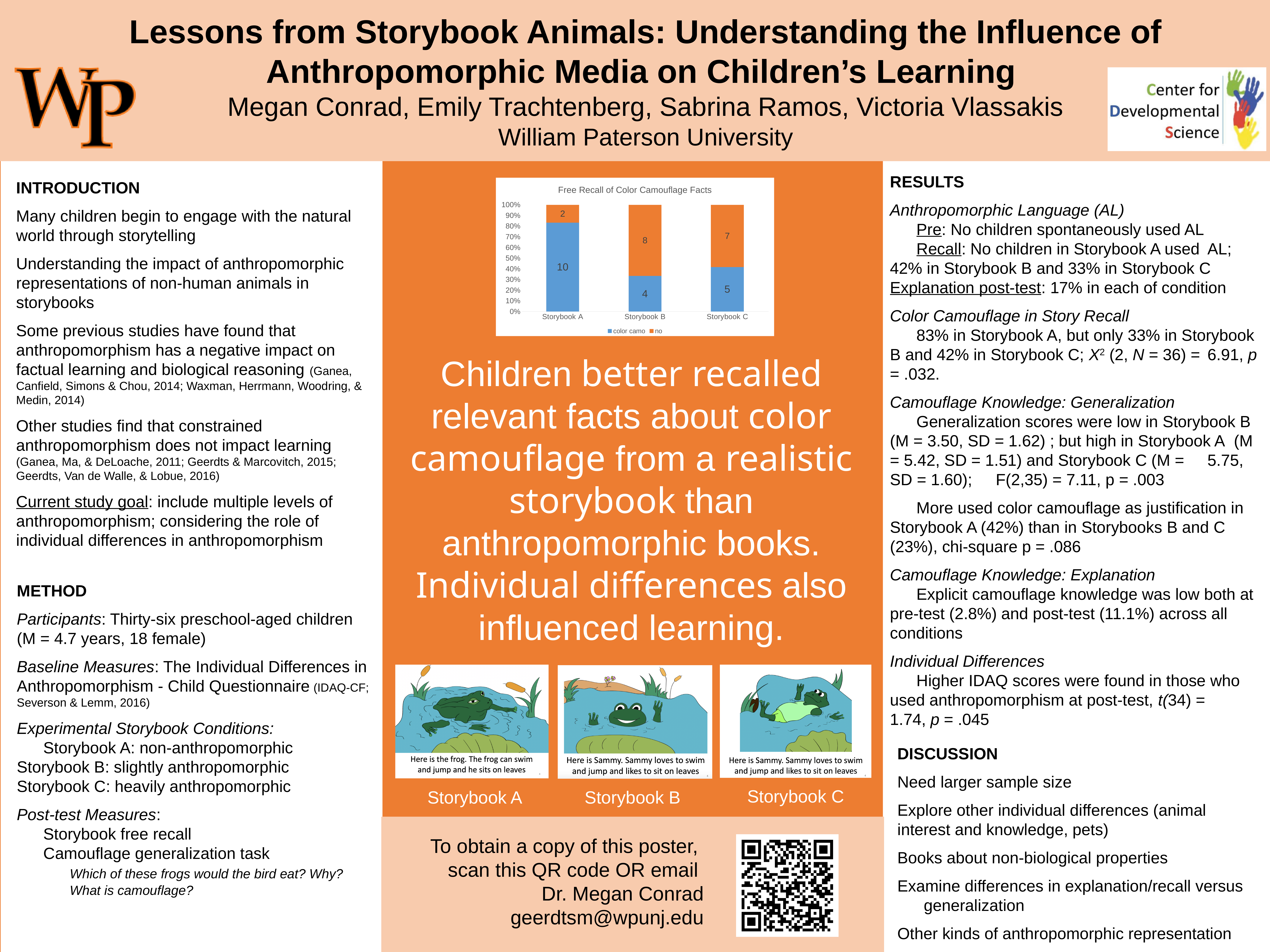
What is the difference between the 'color camo' values for Storybook A and Storybook B? 6 What is the total of the two segments in the Storybook C bar? 12 How many storybook categories are shown on the x axis of the chart? 3 Which storybook has the lowest 'no' value? Storybook A What is the 'no' value for Storybook B? 8 What type of chart is shown on the slide? stacked bar chart Which storybook has the highest 'color camo' value? Storybook A What is the 'color camo' value for Storybook A? 10 Which is larger: the 'no' value for Storybook B or the 'no' value for Storybook C? Storybook B What is the 'color camo' value for Storybook C? 5 What is the title of the chart? Free Recall of Color Camouflage Facts How many series does the chart's legend list? 2